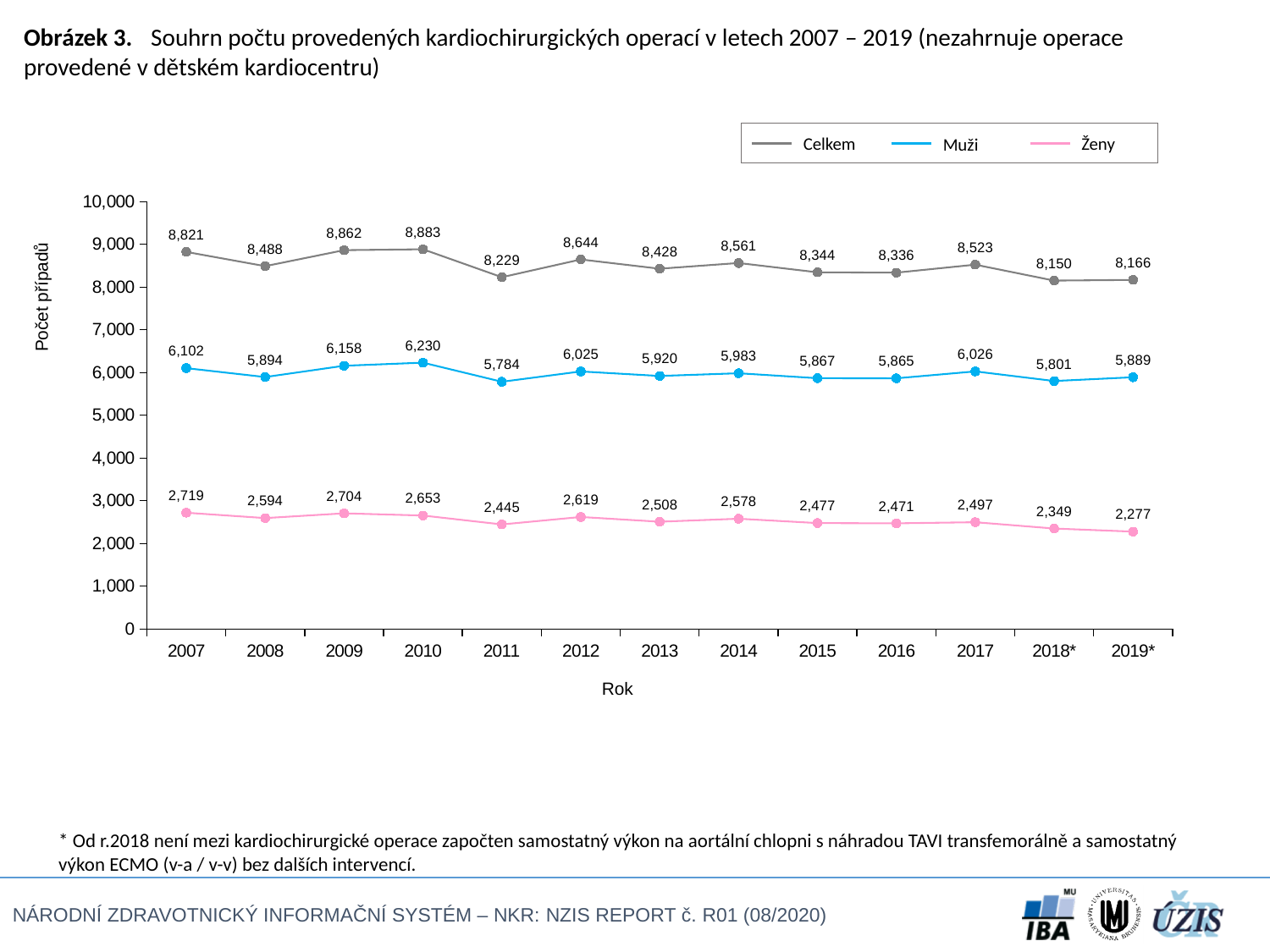
What is the value of the Muži series for 2011? 5,784 Which is larger, the Muži value for 2009 or the Muži value for 2017? 2009 What is the label of the y axis? Počet případů Is the Celkem value for 2018* greater or less than 8,000? greater What is the value of the Celkem series for 2010? 8,883 What kind of chart is shown on the slide? line chart In which year is the Celkem series highest? 2010 In which year is the Ženy series lowest? 2019* What is the value of the Ženy series for 2019*? 2,277 How many series does the legend list? 3 What is the difference between the Celkem values for 2007 and 2008? 333 How many years are shown on the x axis? 13